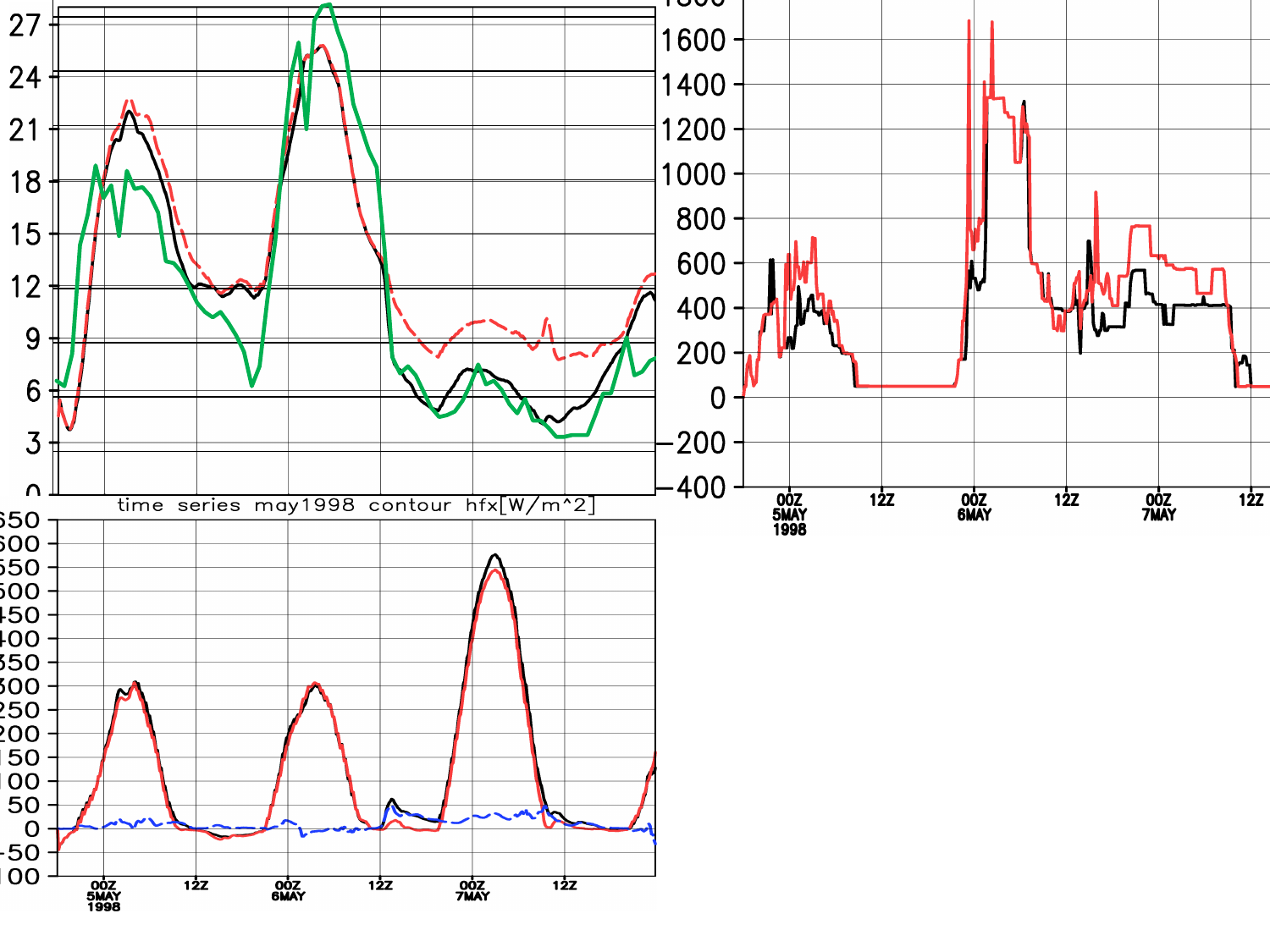
In the top-right chart, how many lines are plotted? 2 In the bottom-left chart, is the highest peak of the black line greater or less than 550? greater In the top-right chart, is the highest peak of the red line greater or less than 1600? greater What kind of chart is the bottom-left chart titled 'time series may1998 contour hfx[W/m^2]'? line chart In the bottom-left chart, is the peak of the black line near 00Z 5MAY greater or less than 350? less What is the title of the bottom-left chart? time series may1998 contour hfx[W/m^2] In the top-left chart, how many lines are plotted? 3 In the bottom-left chart, how many lines are plotted? 3 In the bottom-left chart, on which day does the black line reach its highest peak? 7MAY